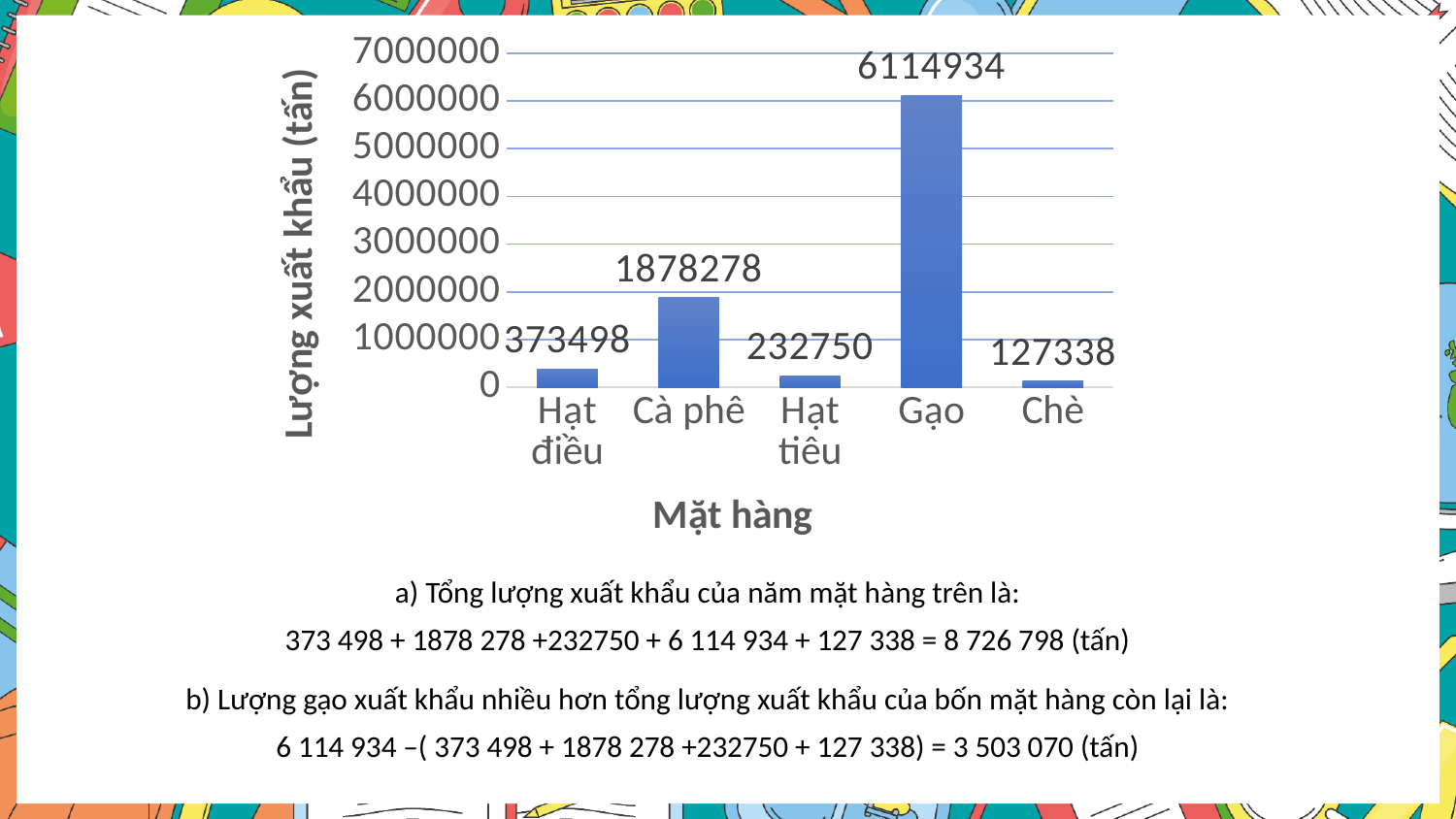
What kind of chart is shown? Bar chart What is the difference between the export volumes of Gạo and Cà phê? 4236656 What is the export volume for Cà phê? 1878278 Which item has the lowest export volume? Chè What is the label of the vertical axis? Lượng xuất khẩu (tấn) Which has a larger export volume, Hạt điều or Hạt tiêu? Hạt điều What is the export volume for Gạo? 6114934 Is the value for Cà phê greater or less than 1000000? greater Which item has the highest export volume? Gạo How many items are shown on the x axis? 5 What is the export volume for Hạt tiêu? 232750 What is the export volume for Chè? 127338